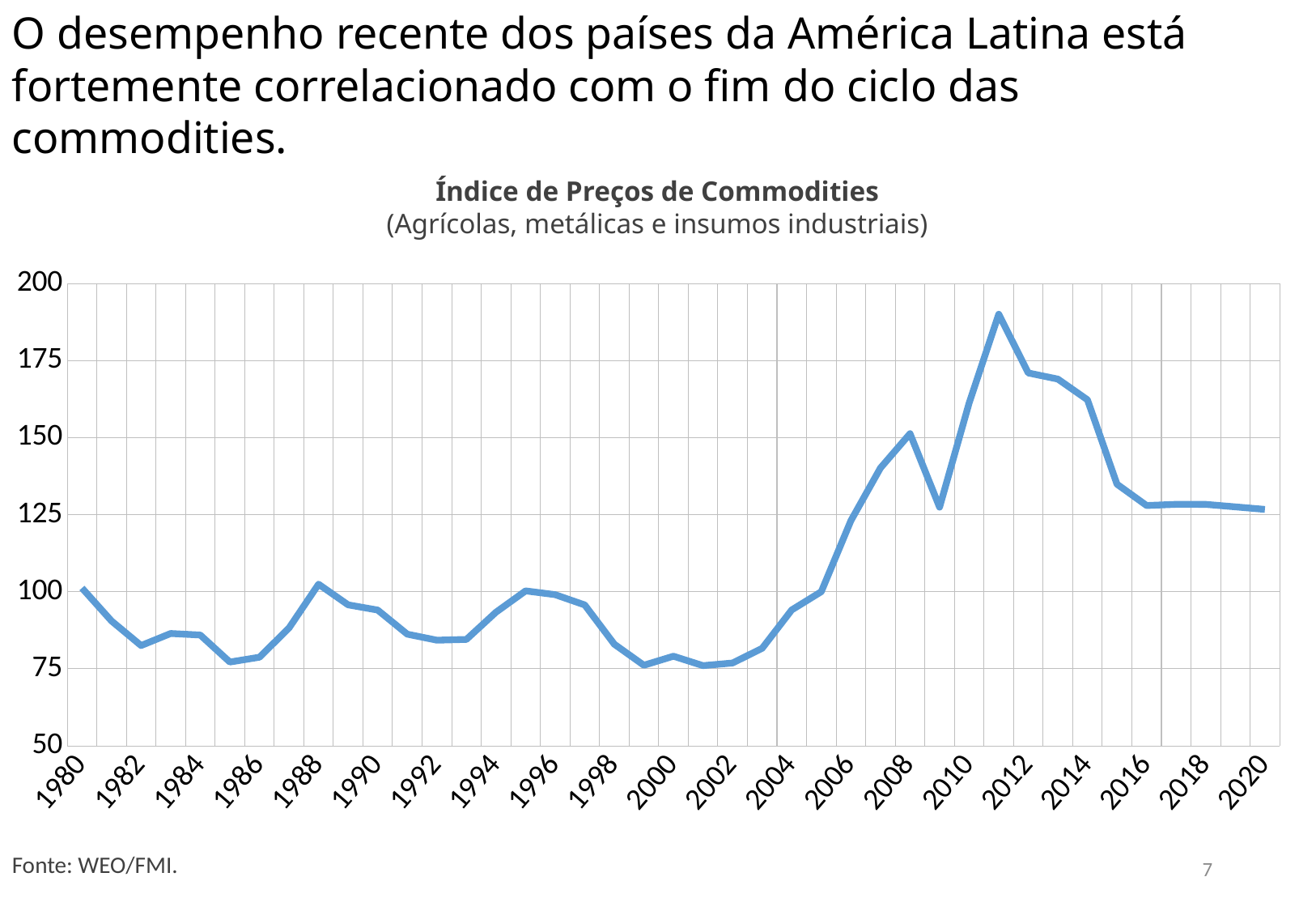
Is the value for 2011 greater or less than 175? greater Is the value for 2001 greater or less than 100? less In which year does the commodity price index reach its highest value? 2011 What kind of chart is shown on the slide? line chart Is the value for 2015 greater or less than 125? greater What source is cited for the chart? WEO/FMI Which is larger, the value for 2011 or the value for 2008? 2011 Does the index rise or fall between 2002 and 2008? rise Does the index rise or fall between 2011 and 2016? fall What is the title of the chart? Índice de Preços de Commodities